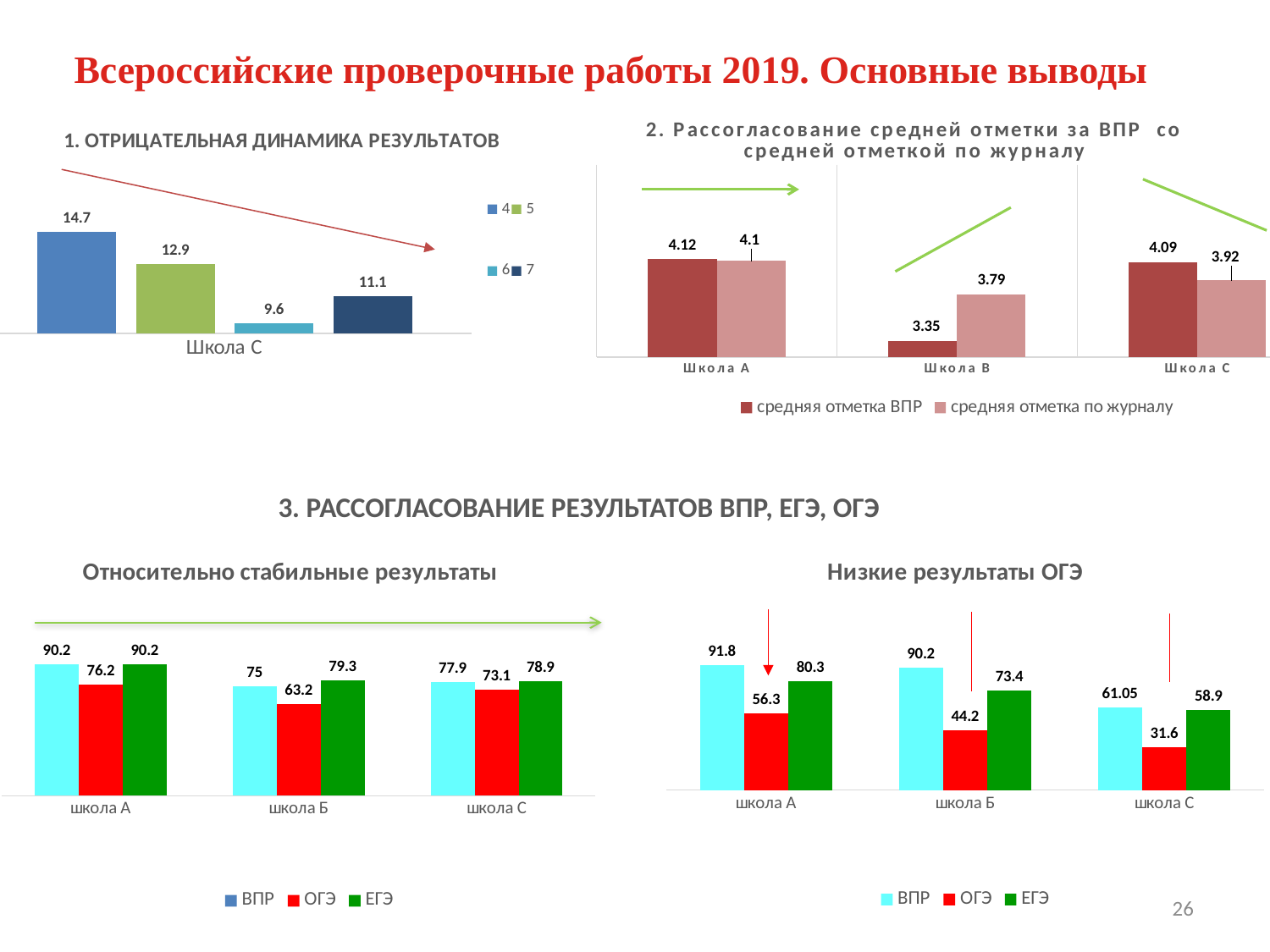
In the chart titled "2. Рассогласование средней отметки за ВПР со средней отметкой по журналу", what is the difference between средняя отметка по журналу and средняя отметка ВПР for Школа В? 0.44 In the chart titled "Низкие результаты ОГЭ", what is the ВПР value for школа С? 61.05 In the chart titled "Относительно стабильные результаты", what is the difference between the ЕГЭ and ОГЭ values for школа А? 14 In the chart titled "1. ОТРИЦАТЕЛЬНАЯ ДИНАМИКА РЕЗУЛЬТАТОВ", what is the value for series 4 at Школа С? 14.7 In the chart titled "1. ОТРИЦАТЕЛЬНАЯ ДИНАМИКА РЕЗУЛЬТАТОВ", which series has the lowest value? 6 In the chart titled "Относительно стабильные результаты", what is the ОГЭ value for школа Б? 63.2 In the chart titled "2. Рассогласование средней отметки за ВПР со средней отметкой по журналу", which is larger for Школа С: средняя отметка ВПР or средняя отметка по журналу? средняя отметка ВПР In the chart titled "2. Рассогласование средней отметки за ВПР со средней отметкой по журналу", how many schools are shown on the x axis? 3 In the chart titled "1. ОТРИЦАТЕЛЬНАЯ ДИНАМИКА РЕЗУЛЬТАТОВ", how many series does the legend list? 4 In the chart titled "2. Рассогласование средней отметки за ВПР со средней отметкой по журналу", what is the средняя отметка ВПР for Школа В? 3.35 In the chart titled "Низкие результаты ОГЭ", which school has the lowest ОГЭ value? школа С What type of chart is the one titled "Низкие результаты ОГЭ"? bar chart